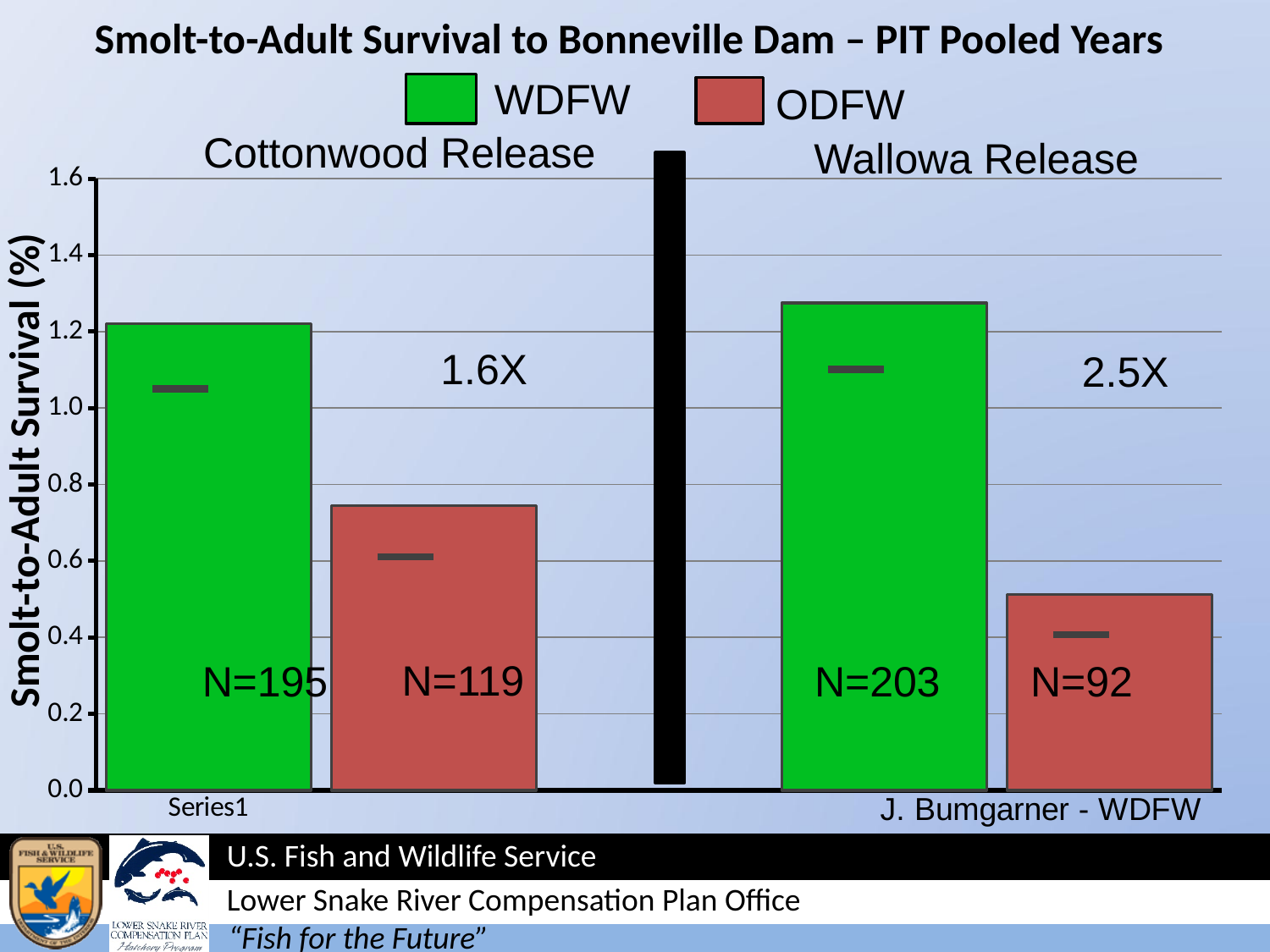
Which bar has the lowest smolt-to-adult survival? Wallowa Release ODFW Is the value for the Cottonwood Release WDFW bar greater or less than 1.0? greater Is the value for the Wallowa Release ODFW bar greater or less than 0.6? less In the Wallowa Release group, which is larger, the WDFW bar or the ODFW bar? WDFW What is the label on the y axis of the chart? Smolt-to-Adult Survival (%) How many series does the legend list? 2 Which bar has the highest smolt-to-adult survival? Wallowa Release WDFW What sample size (N) is printed on the Cottonwood Release ODFW bar? N=119 Is the value for the Cottonwood Release ODFW bar greater or less than 0.8? less What ratio label is printed next to the Wallowa Release bars? 2.5X What kind of chart is shown on the slide? bar chart How many bars are plotted in the chart? 4